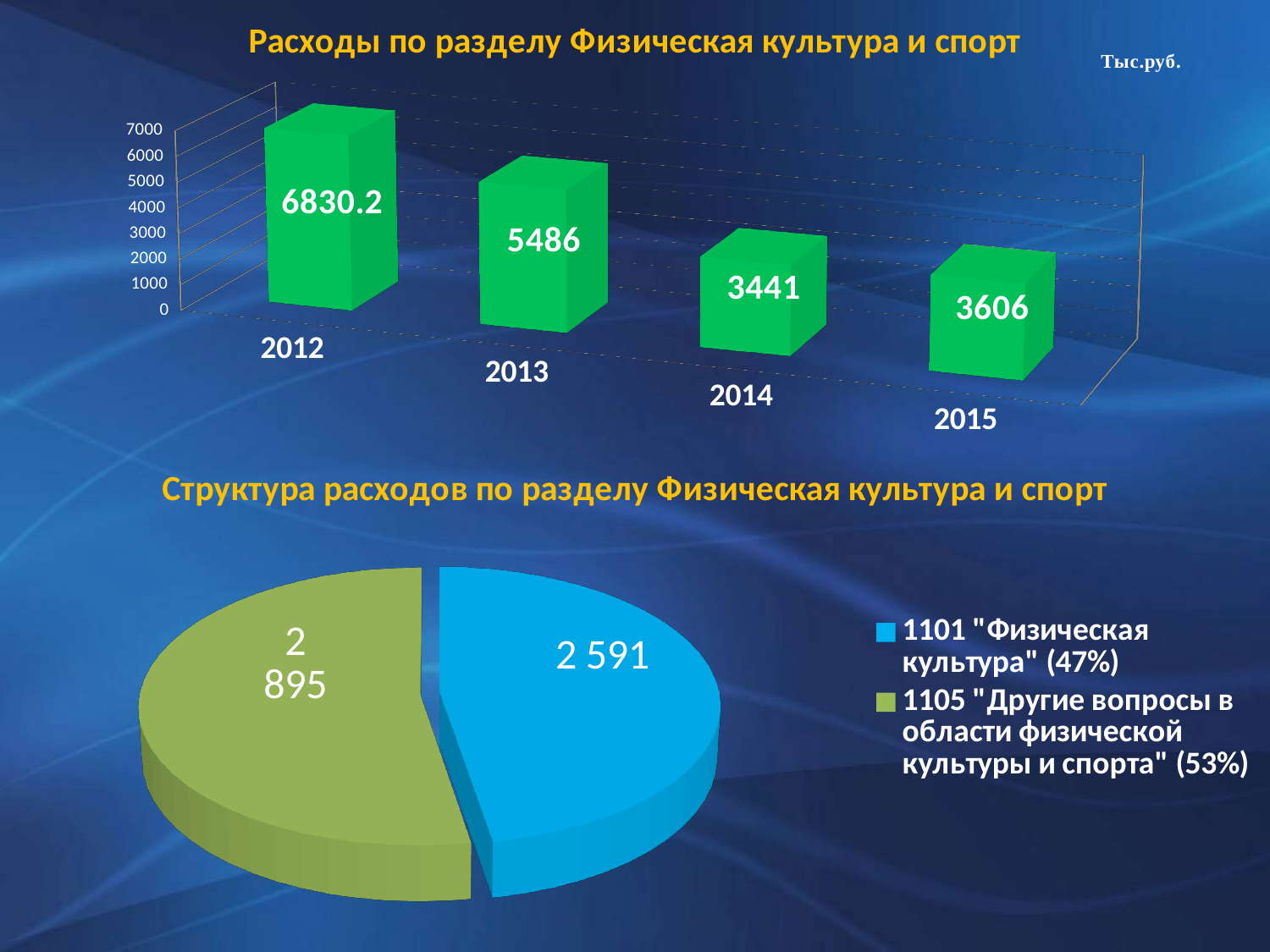
In the bar chart 'Расходы по разделу Физическая культура и спорт', what is the difference between the values for 2013 and 2015? 1880 In the bar chart 'Расходы по разделу Физическая культура и спорт', what is the value for 2012? 6830.2 In the bar chart 'Расходы по разделу Физическая культура и спорт', what is the value for 2014? 3441 In the bar chart 'Расходы по разделу Физическая культура и спорт', which year has the highest value? 2012 In the bar chart 'Расходы по разделу Физическая культура и спорт', do the values rise or fall from 2012 to 2014? Fall In the bar chart 'Расходы по разделу Физическая культура и спорт', how many years are shown? 4 What kind of chart is the top chart on the slide? Bar chart In the pie chart 'Структура расходов по разделу Физическая культура и спорт', what share does 1105 "Другие вопросы в области физической культуры и спорта" have? 53% In the pie chart 'Структура расходов по разделу Физическая культура и спорт', what is the value for 1101 "Физическая культура"? 2 591 In the bar chart 'Расходы по разделу Физическая культура и спорт', which year has the lowest value? 2014 In the bar chart 'Расходы по разделу Физическая культура и спорт', which is larger, the value for 2014 or the value for 2015? 2015 In the pie chart 'Структура расходов по разделу Физическая культура и спорт', what colour is the slice for 1101 "Физическая культура"? Blue